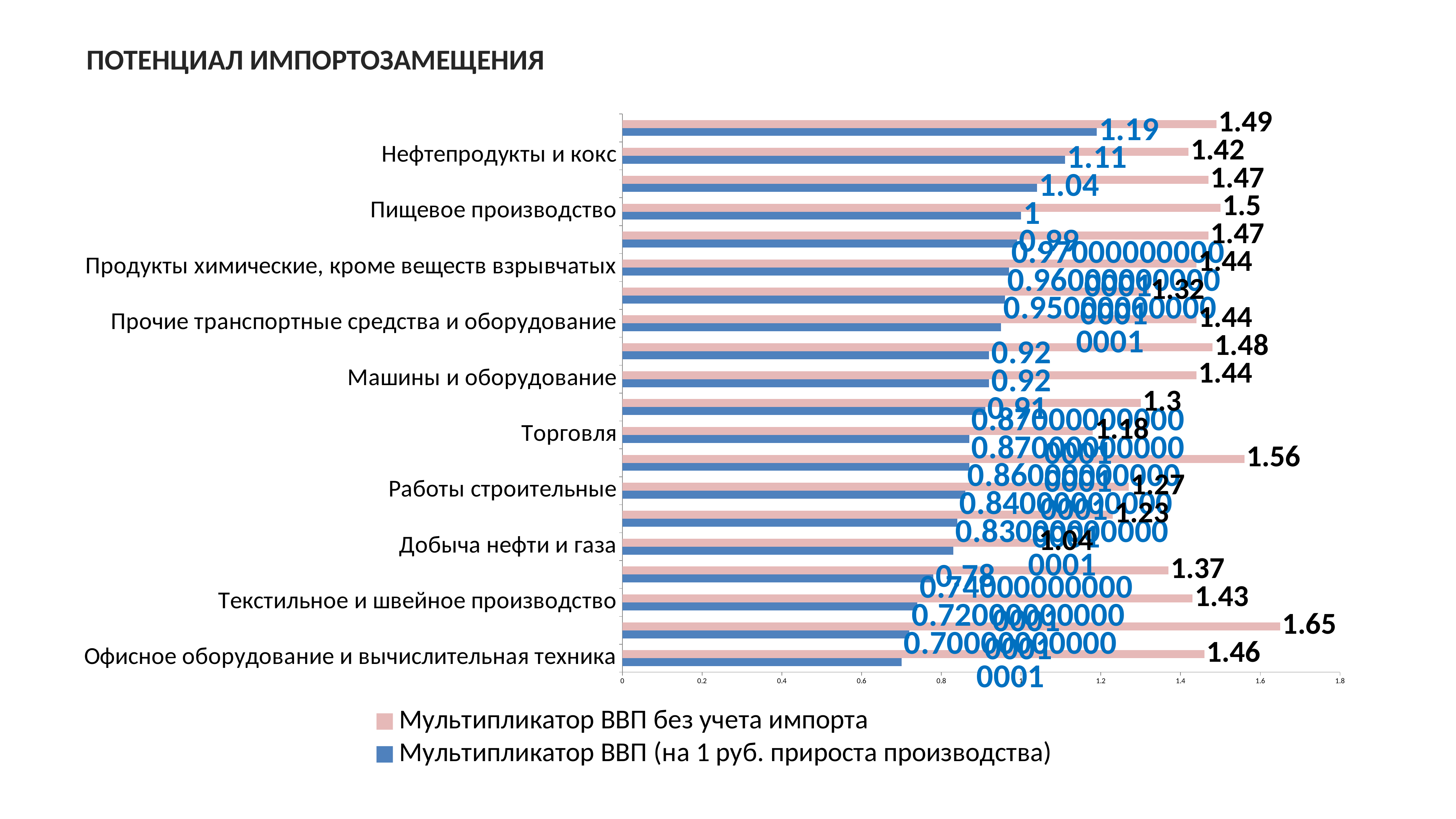
What is the value of 'Мультипликатор ВВП без учета импорта' for Торговля? 1.18 What is the value of 'Мультипликатор ВВП (на 1 руб. прироста производства)' for Нефтепродукты и кокс? 1.11 What is the value of 'Мультипликатор ВВП без учета импорта' for Нефтепродукты и кокс? 1.42 How many series does the legend list? 2 What is the value of 'Мультипликатор ВВП без учета импорта' for Пищевое производство? 1.5 Which category has the lowest value of 'Мультипликатор ВВП без учета импорта'? Добыча нефти и газа Is the value of 'Мультипликатор ВВП (на 1 руб. прироста производства)' for Офисное оборудование и вычислительная техника greater or less than 0.8? less What is the value of 'Мультипликатор ВВП без учета импорта' for Добыча нефти и газа? 1.04 What type of chart is shown on the slide? bar chart For Нефтепродукты и кокс, what is the difference between 'Мультипликатор ВВП без учета импорта' and 'Мультипликатор ВВП (на 1 руб. прироста производства)'? 0.31 What is the value of 'Мультипликатор ВВП (на 1 руб. прироста производства)' for Пищевое производство? 1 Which has the larger 'Мультипликатор ВВП без учета импорта' value: Пищевое производство or Торговля? Пищевое производство